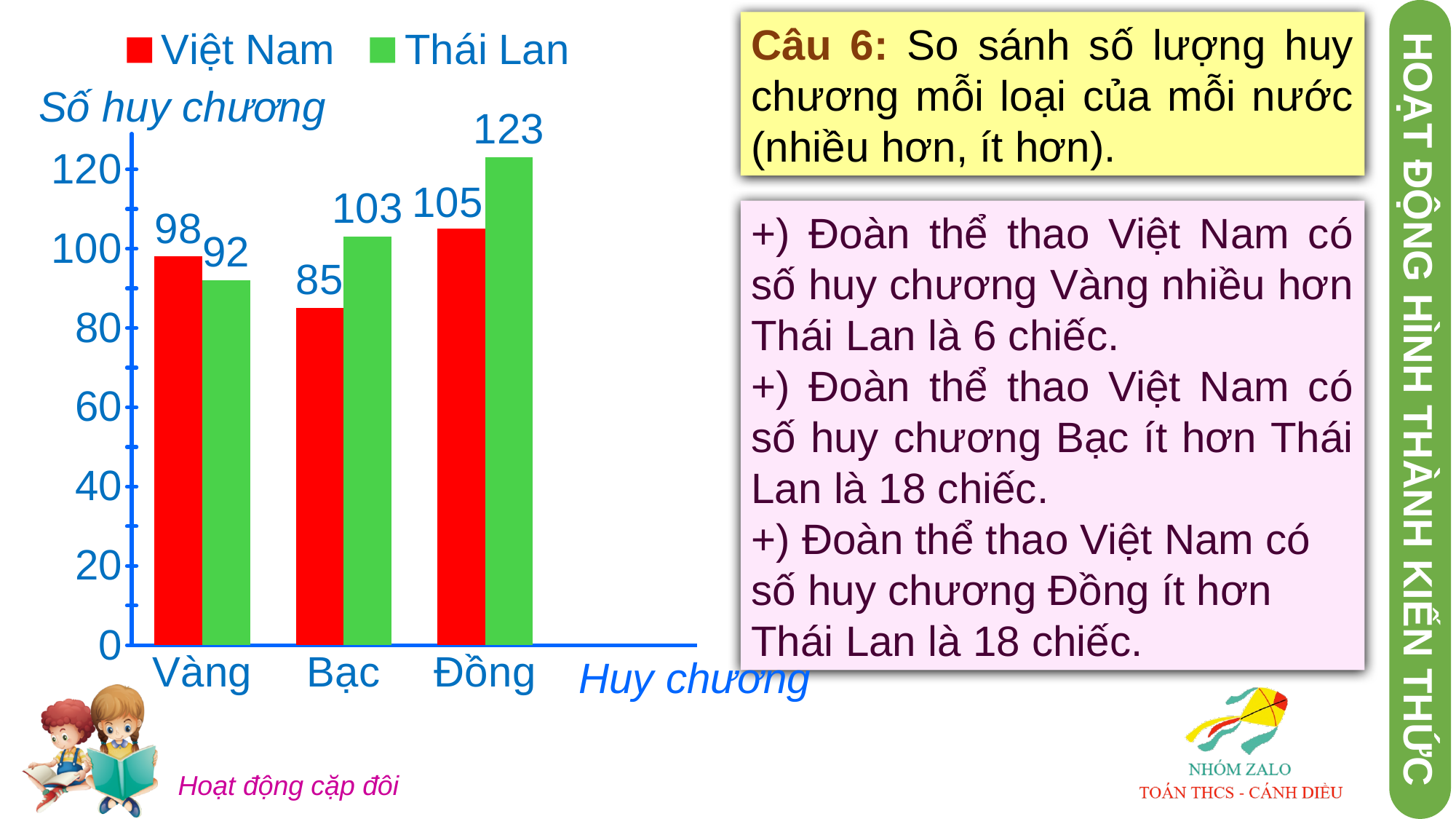
Which category has the lowest value for Việt Nam? Bạc What is the difference between Thái Lan and Việt Nam in the Bạc category? 18 What is the value for Việt Nam in the Vàng category? 98 What is the value for Thái Lan in the Đồng category? 123 What is the value for Việt Nam in the Đồng category? 105 How many categories are shown on the x axis? 3 What kind of chart is shown on the slide? bar chart What is the value for Thái Lan in the Bạc category? 103 Which category has the highest value for Thái Lan? Đồng Is the value for Thái Lan in the Vàng category greater or less than 100? less Which is larger in the Vàng category, Việt Nam or Thái Lan? Việt Nam How many series does the legend list? 2